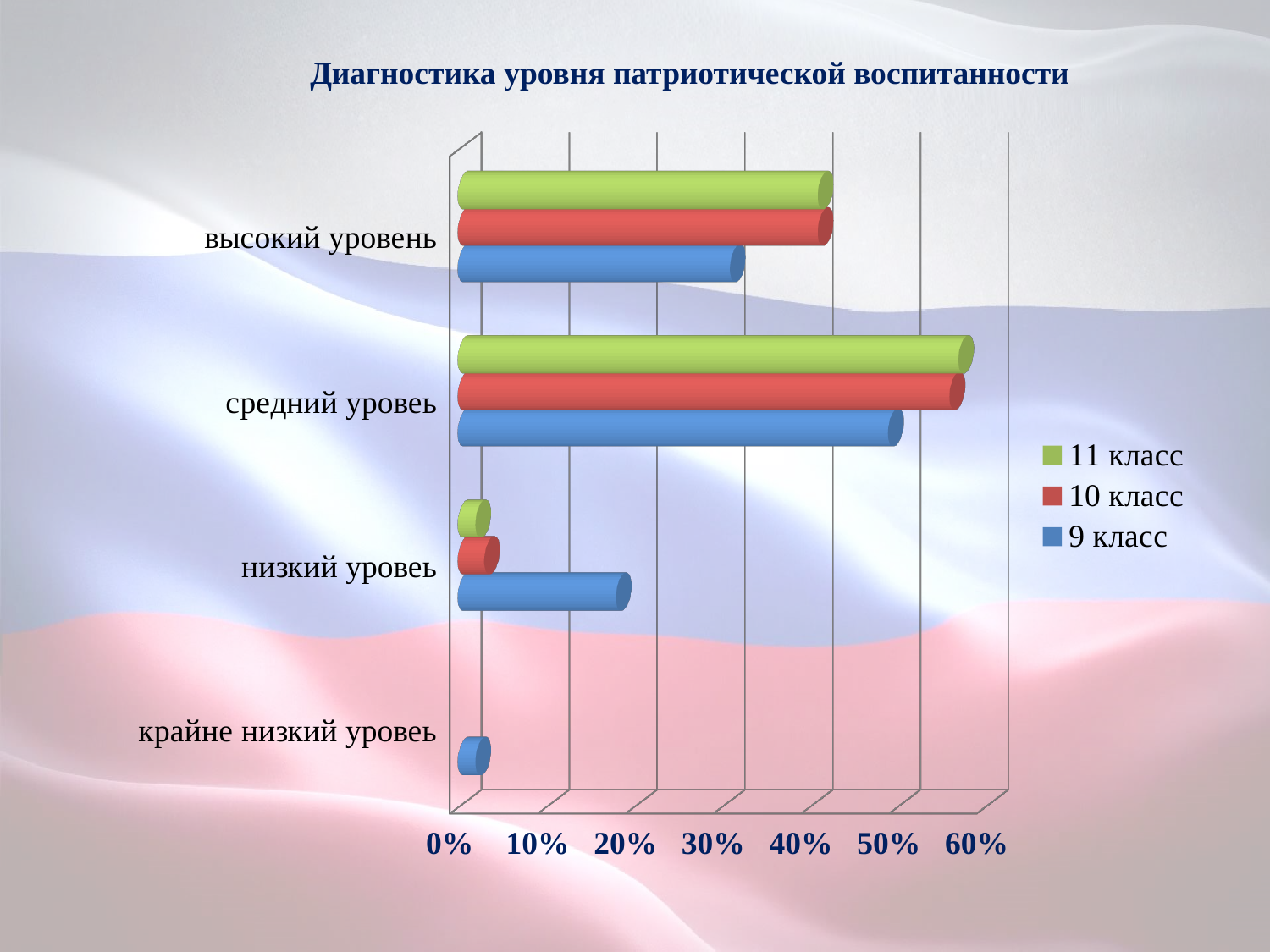
For низкий уровеь, which is larger: the value for 9 класс or for 11 класс? 9 класс What is the title of the chart? Диагностика уровня патриотической воспитанности How many categories are shown on the vertical axis? 4 Which category has the lowest value for 9 класс? крайне низкий уровеь Is the value for 11 класс at средний уровеь greater or less than 50%? greater How many series does the legend list? 3 For средний уровеь, which is larger: the value for 11 класс or for 9 класс? 11 класс Is the value for 9 класс at низкий уровеь greater or less than 10%? greater Is the value for 9 класс at высокий уровень greater or less than 40%? less What kind of chart is shown on the slide? bar chart Which series is shown in green in the legend? 11 класс Which category has the highest value for 11 класс? средний уровеь